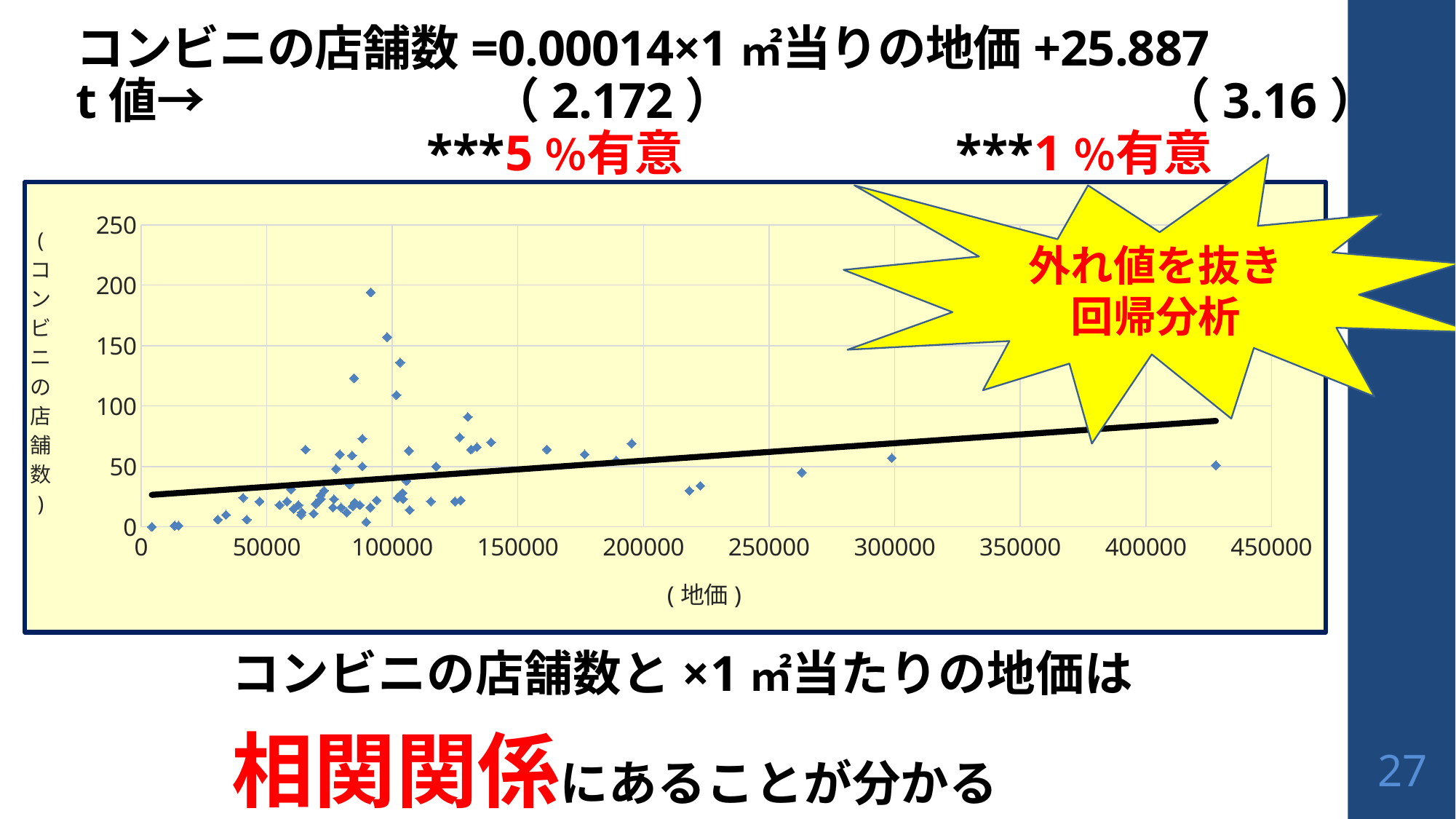
What is the highest value shown on the y axis of the chart? 250 Is the x value of the highest plotted point greater or less than 150000? less What is the label of the y axis of the chart? (コンビニの店舗数) Does the fitted trend line rise or fall as 地価 increases along the x axis? rises What is the label of the x axis of the chart? (地価) According to the regression equation on the slide, what is the coefficient of 1㎡当りの地価? 0.00014 According to the regression equation on the slide, what is the intercept? 25.887 Is the highest plotted point in the chart greater or less than 150 on the y axis? greater Is the y value of the point plotted near 300000 on the x axis greater or less than 100? less What kind of chart is shown on the slide? scatter plot What is the highest value shown on the x axis of the chart? 450000